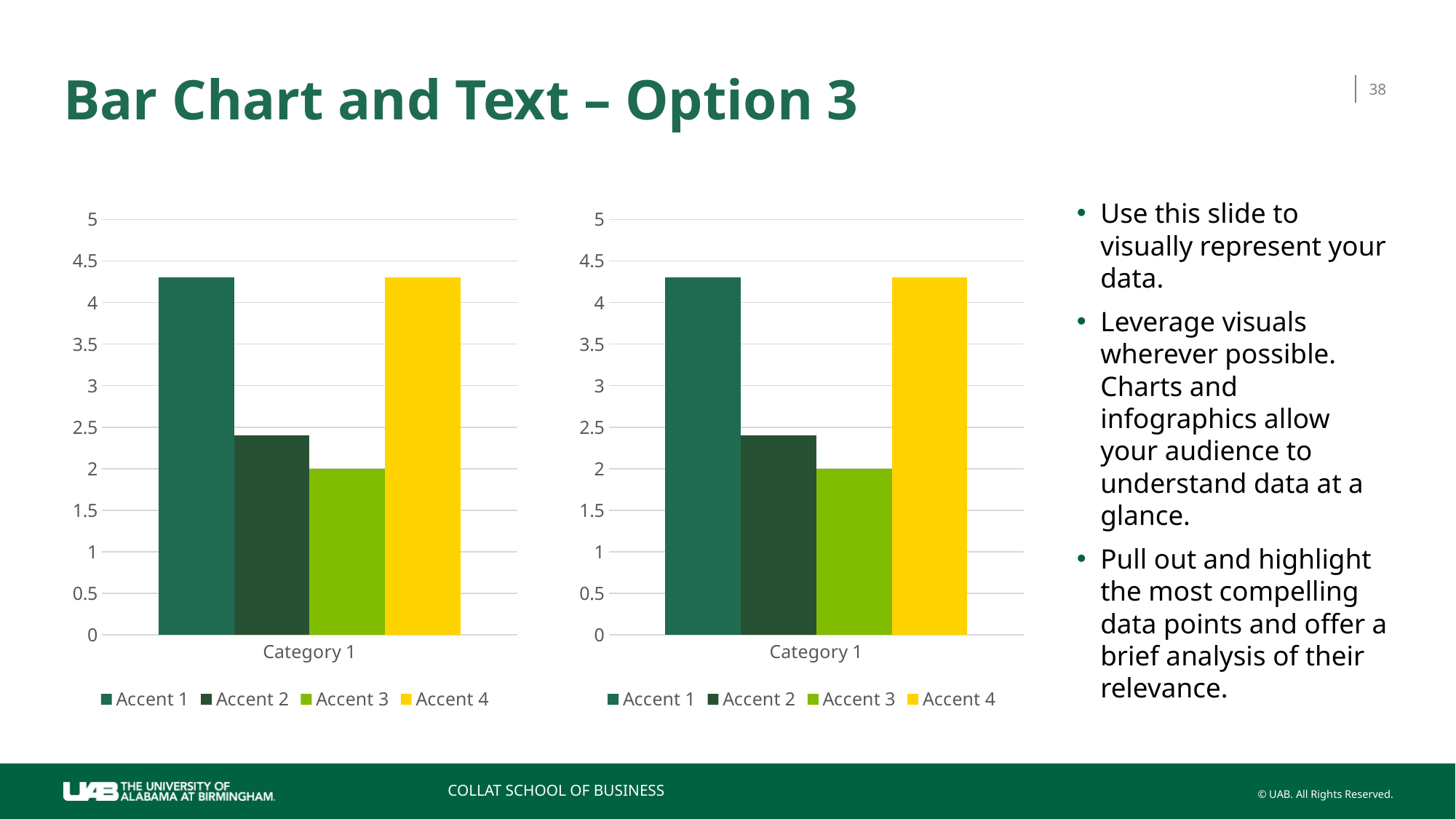
What is the label of the single category on the x axis of the left chart? Category 1 In the right chart, which series has the lowest value? Accent 3 In the left chart, is the value for Accent 4 greater or less than 4? greater What kind of chart is the left chart on the slide? bar chart In the right chart, what colour is the bar for Accent 4? yellow In the right chart, which is larger, the value for Accent 1 or the value for Accent 2? Accent 1 In the right chart, is the value for Accent 2 greater or less than 3? less In the left chart, is the value for Accent 1 greater or less than 4? greater In the left chart, what is the value for Accent 3? 2 How many categories are shown on the x axis of the right chart? 1 How many series does the legend of the left chart list? 4 In the left chart, which is larger, the value for Accent 3 or the value for Accent 4? Accent 4